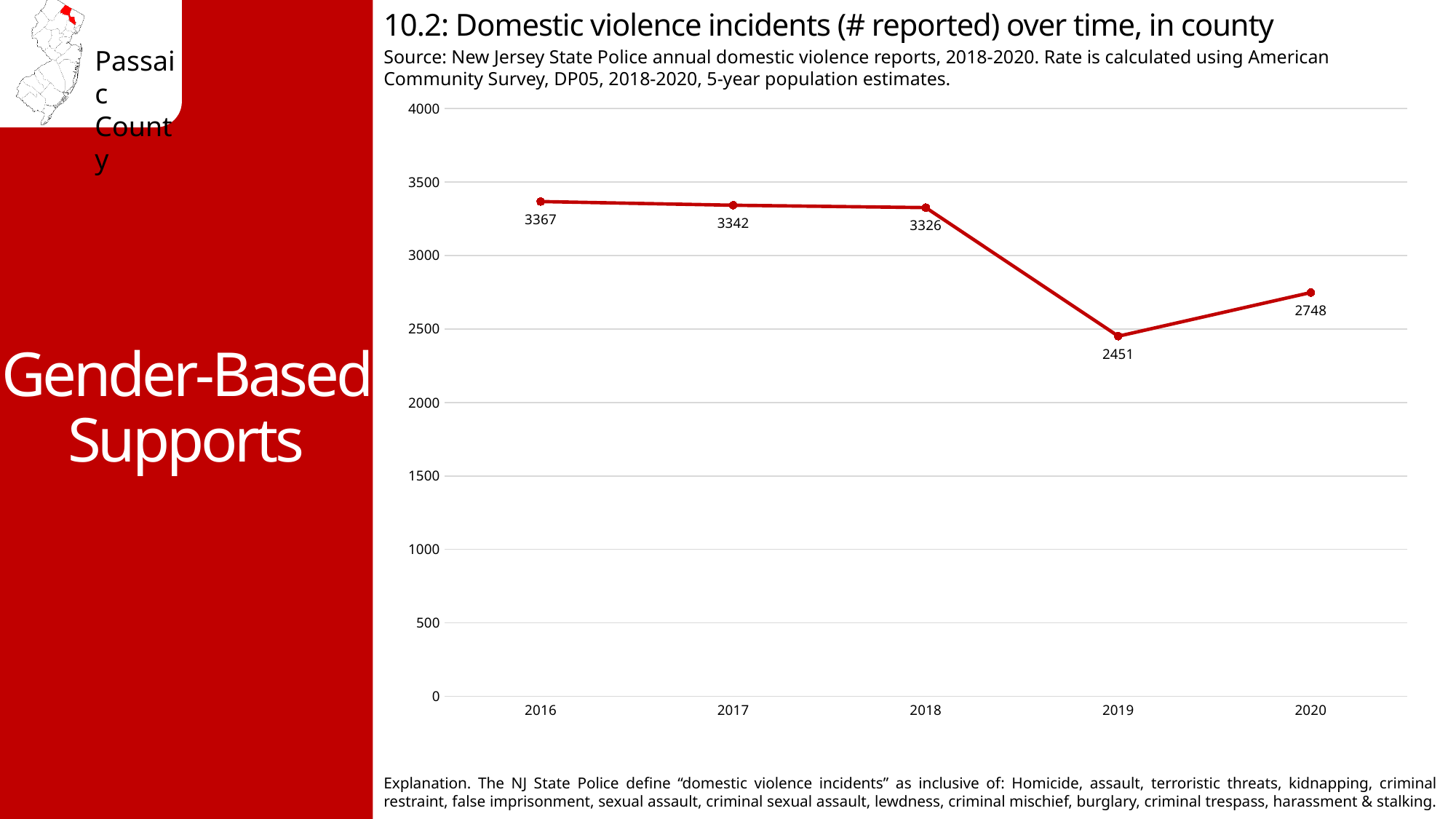
Did the number of reported incidents rise or fall from 2016 to 2019? fall What was the number of reported domestic violence incidents in 2016? 3367 Is the value for 2019 greater or less than 2500? less What was the number of reported domestic violence incidents in 2020? 2748 What kind of chart is shown on the slide? line chart What is the difference between the number of incidents in 2020 and 2019? 297 What is the difference between the number of incidents in 2018 and 2019? 875 What was the number of reported domestic violence incidents in 2019? 2451 How many years are plotted on the chart? 5 Which year had the highest number of reported domestic violence incidents? 2016 Which year had the lowest number of reported domestic violence incidents? 2019 Which year had more reported incidents, 2017 or 2020? 2017